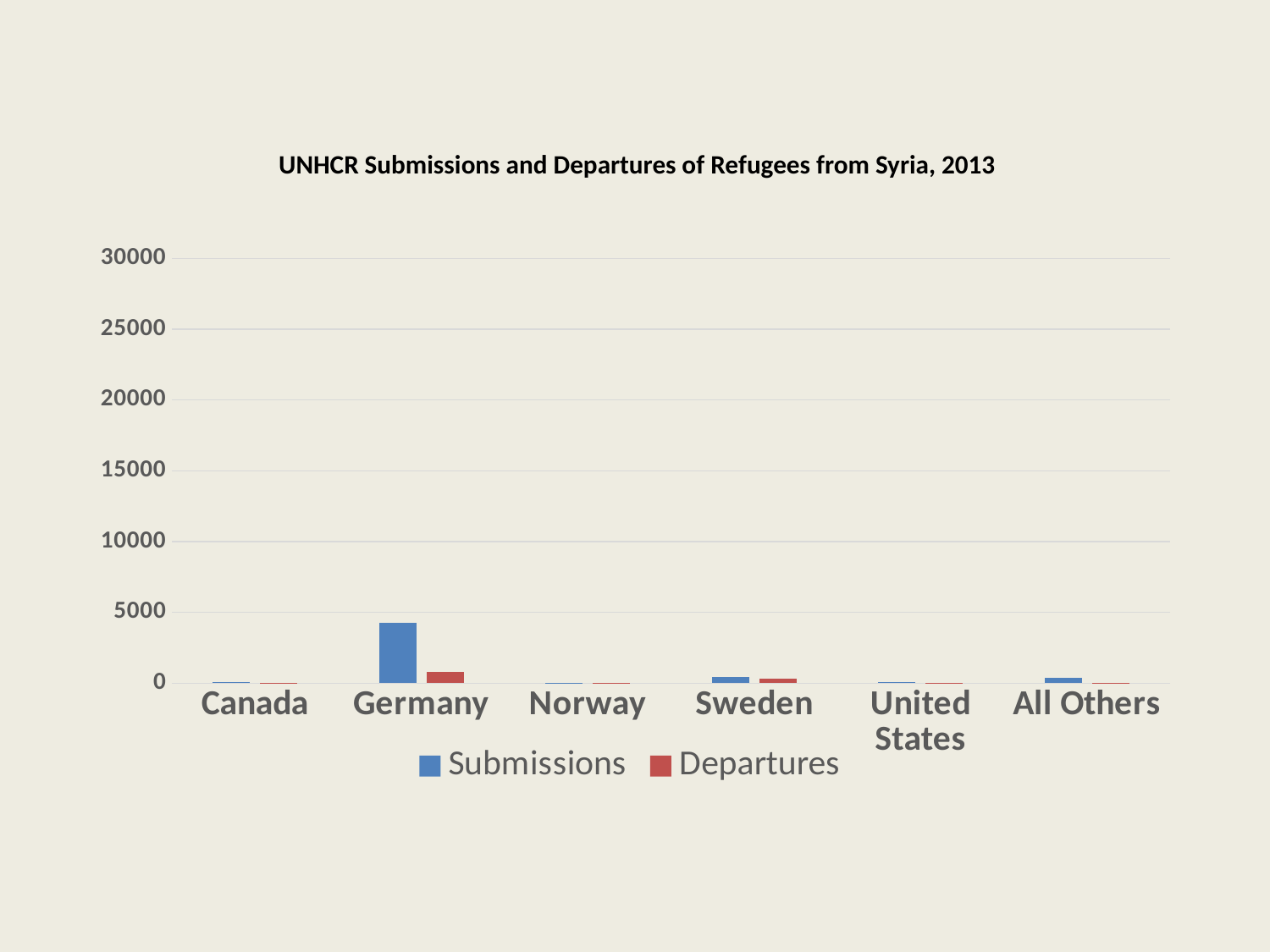
What is the title of the chart? UNHCR Submissions and Departures of Refugees from Syria, 2013 What is the highest value shown on the y axis? 30000 How many categories are shown on the x axis? 6 How many series does the legend list? 2 Is the Departures value for Germany greater or less than 5000? less Which category has the highest Submissions value? Germany Which has the larger Submissions value: Germany or Sweden? Germany For Germany, which is larger: Submissions or Departures? Submissions What kind of chart is shown on the slide? bar chart Is the Submissions value for Germany greater or less than 5000? less Which colour represents Departures in the legend? red Which category has the highest Departures value? Germany